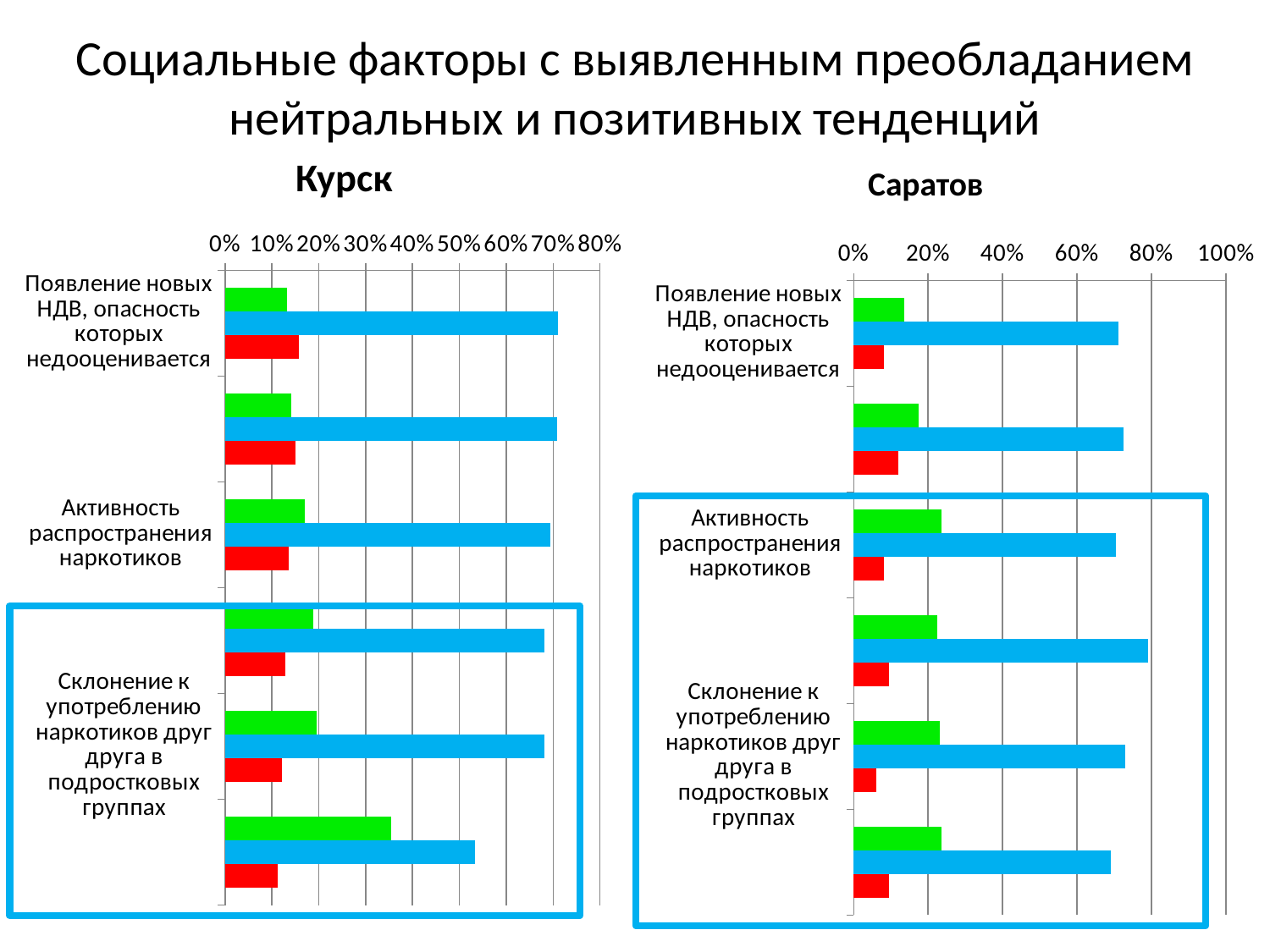
How many groups of bars does the Курск chart contain? 6 In the Саратов chart, is the blue bar for 'Появление новых НДВ, опасность которых недооценивается' greater or less than 60%? greater What kind of chart is the Курск chart? bar chart In the Саратов chart, for 'Появление новых НДВ, опасность которых недооценивается', which bar is longer, the green one or the red one? the green one What is the highest value shown on the horizontal axis of the Курск chart? 80% In the Курск chart, is the red bar for 'Активность распространения наркотиков' greater or less than 20%? less In the Курск chart, for 'Появление новых НДВ, опасность которых недооценивается', which bar is longer, the blue one or the green one? the blue one In the Курск chart, is the blue bar for 'Появление новых НДВ, опасность которых недооценивается' greater or less than 60%? greater What is the highest value shown on the horizontal axis of the Саратов chart? 100% How many bars are shown in each group of the Саратов chart? 3